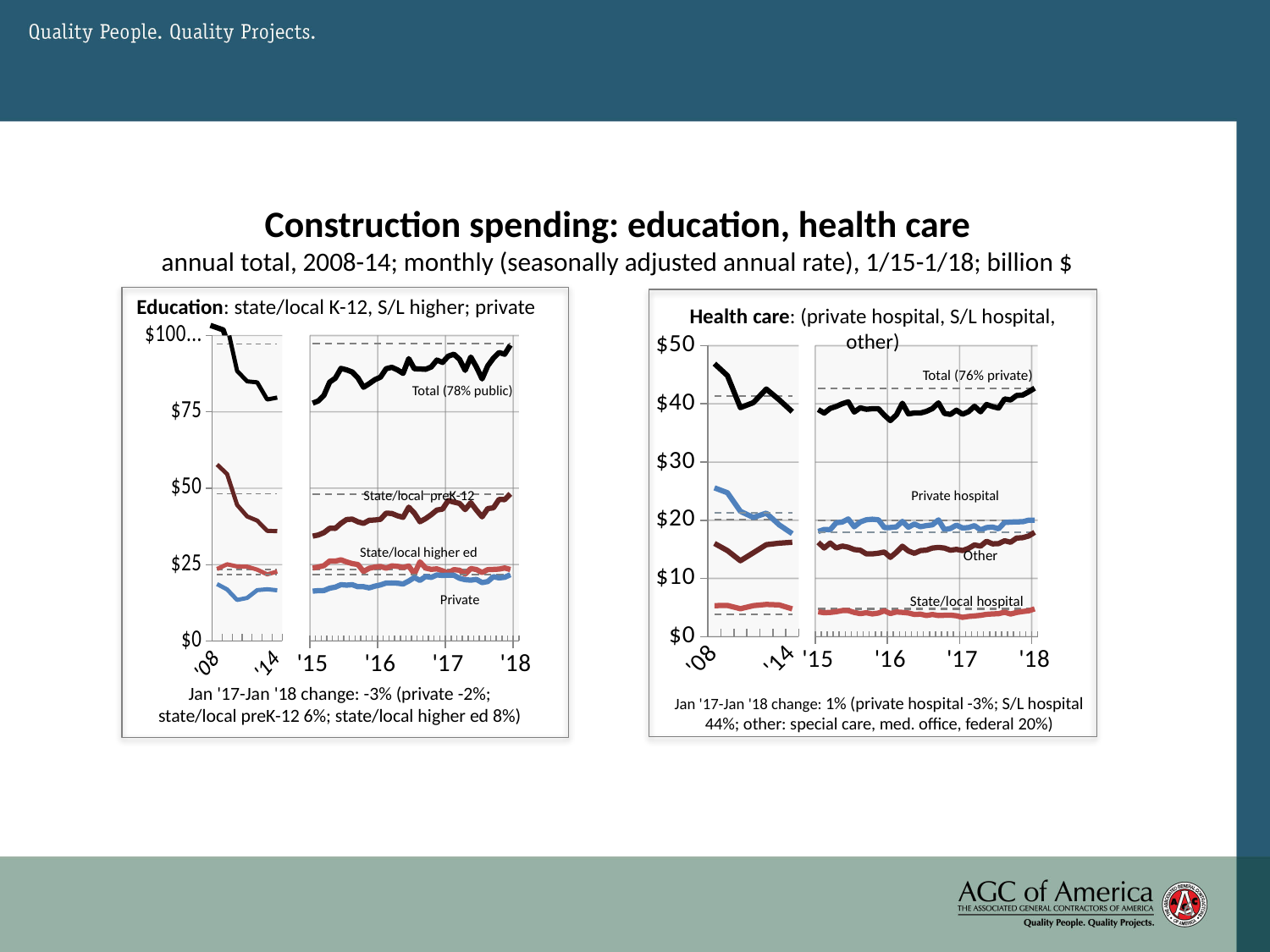
On the Education chart, what is the Jan '17-Jan '18 change for state/local higher ed? 8% On the Health care chart, which series has the lowest values? State/local hospital On the Health care chart, does the Total series rise or fall from 2015 to 2018? rise On the Education chart, is the Private value in 2018 greater or less than $25? less On the Education chart, which series has the highest values? Total (78% public) On the Education chart, is the Total value in 2018 greater or less than $75? greater How many labeled series are plotted on the Health care chart on the right? 4 On the Health care chart, what share of the Total is private, according to the series label? 76% On the Education chart, does the Total series rise or fall from 2008 to 2014? fall What kind of chart is the Education chart on the left? line chart On the Health care chart, is the State/local hospital value in 2018 greater or less than $10? less